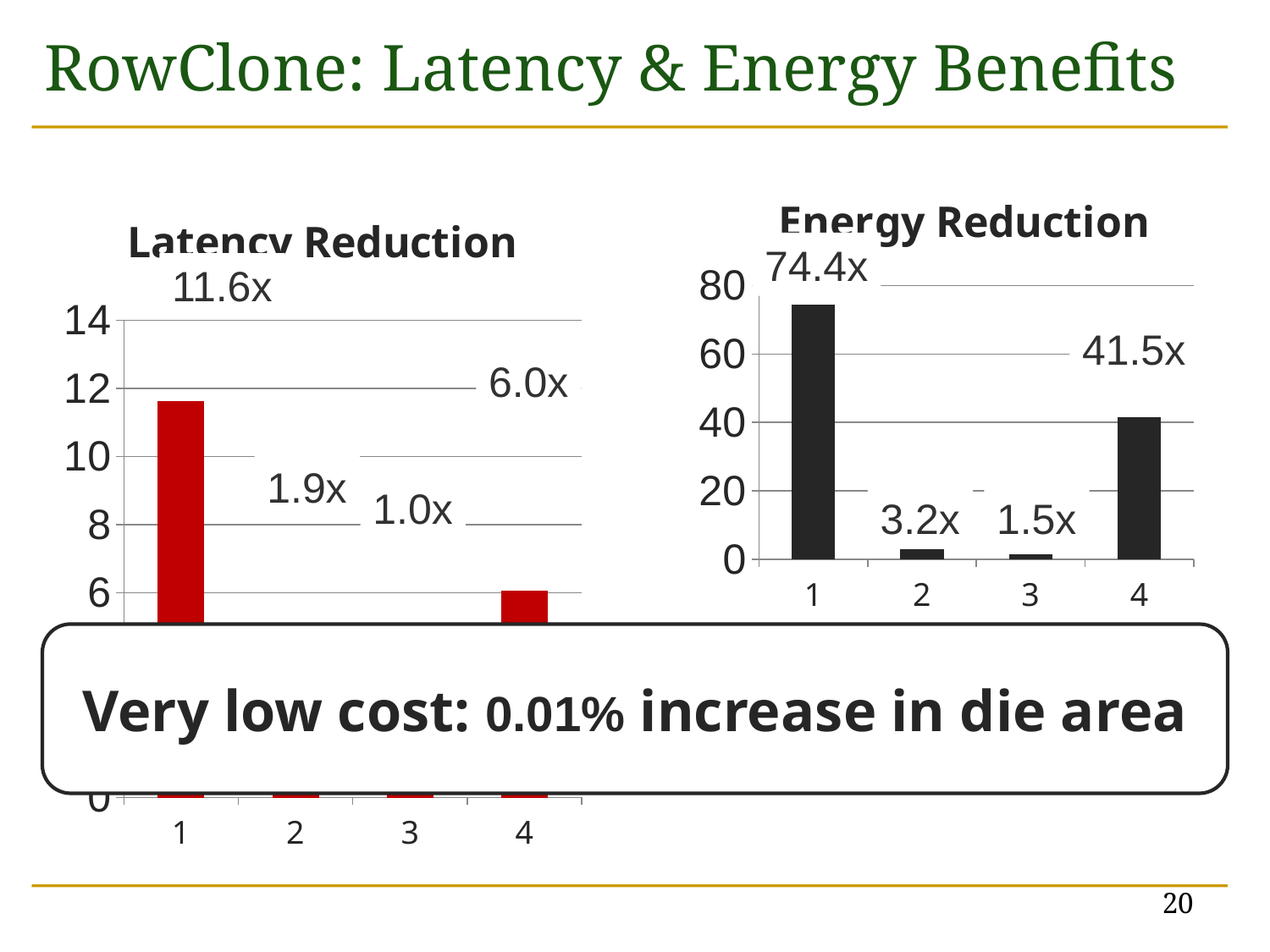
How many categories are shown on the x axis of the Energy Reduction chart? 4 In the Energy Reduction chart, what is the difference between the values for category 1 and category 4? 32.9x What kind of chart is the Latency Reduction chart? bar chart In the Energy Reduction chart, what is the value for category 1? 74.4x In the Energy Reduction chart, is the value for category 4 greater or less than 40? greater In the Latency Reduction chart, what is the value for category 1? 11.6x In the Energy Reduction chart, which category has the highest value? 1 In the Energy Reduction chart, what is the value for category 3? 1.5x In the Latency Reduction chart, which is larger, the value for category 2 or category 4? 4 In the Latency Reduction chart, which category has the lowest value? 3 What colour are the bars in the Latency Reduction chart? red In the Latency Reduction chart, what is the value for category 4? 6.0x